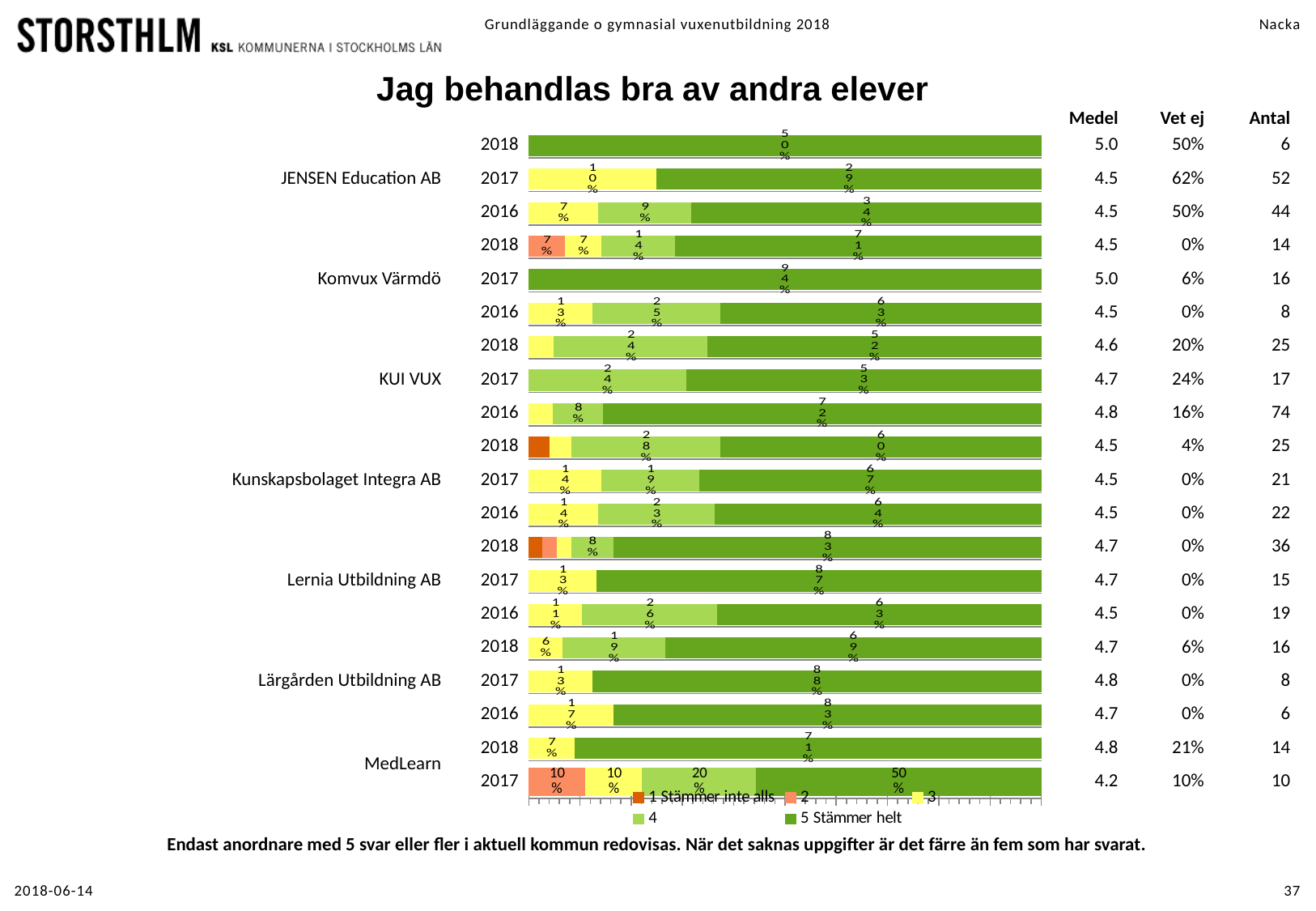
How many series does the legend list? 5 For Lernia Utbildning AB, which year has the larger "5 Stämmer helt" share, 2016 or 2017? 2017 How many education providers are shown in the chart? 7 What percentage of Komvux Värmdö respondents in 2018 answered "2"? 7% What is the "5 Stämmer helt" share for Lärgården Utbildning AB in 2017? 88% What percentage of Komvux Värmdö respondents in 2017 answered "5 Stämmer helt"? 94% What share of Kunskapsbolaget Integra AB respondents in 2016 answered "4"? 23% What is the "4" share for JENSEN Education AB in 2016? 9% What is the difference in the "5 Stämmer helt" share for KUI VUX between 2016 and 2018? 20 percentage points For Komvux Värmdö, which year has the highest "5 Stämmer helt" share? 2017 What kind of chart is shown on the slide? Stacked bar chart